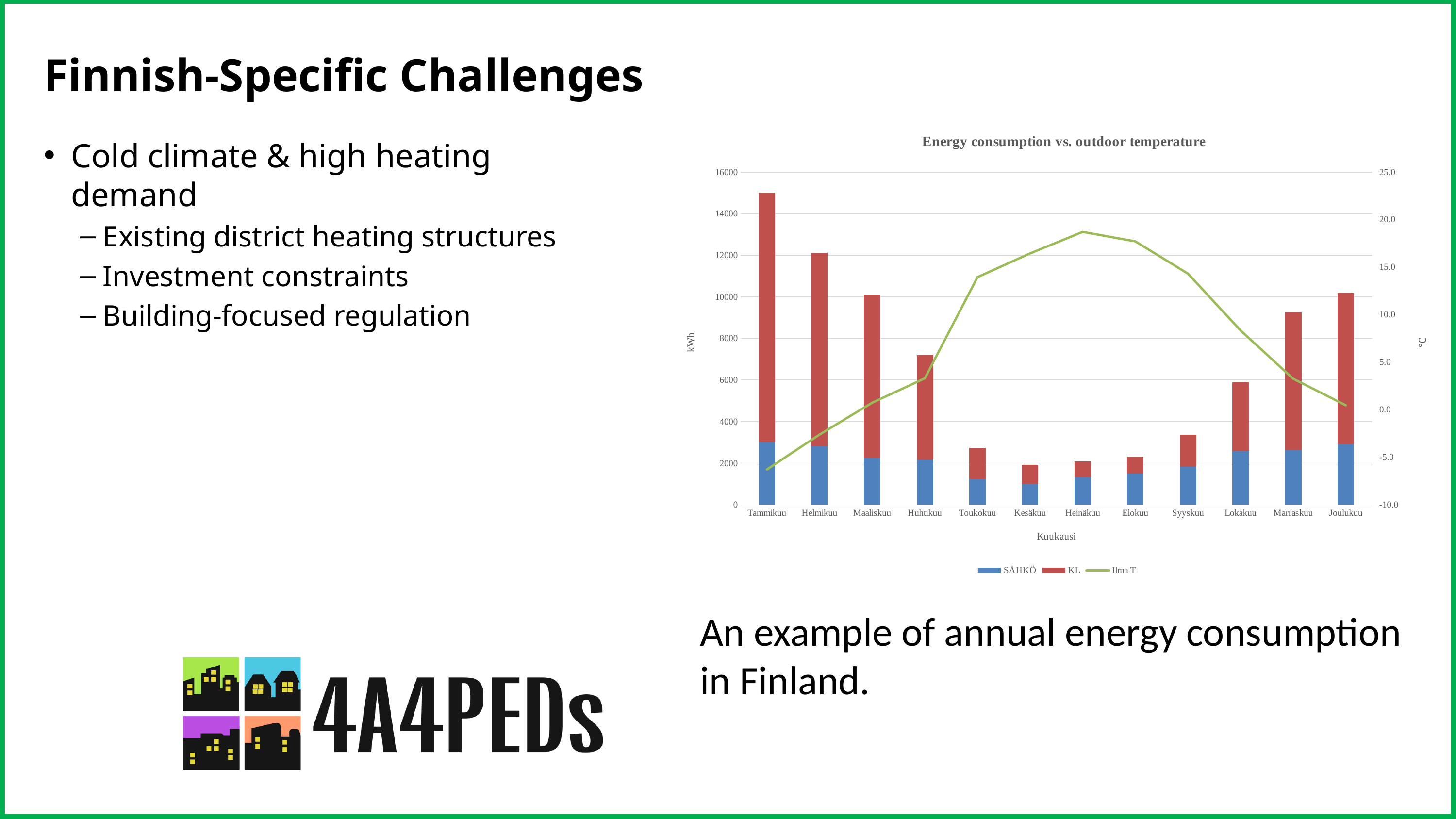
Which month has the larger total energy consumption bar, Tammikuu or Helmikuu? Tammikuu Which series are listed in the chart's legend? SÄHKÖ, KL, Ilma T Is the total energy consumption for Tammikuu greater or less than 14000? greater Is the total energy consumption for Huhtikuu greater or less than 8000? less Is the outdoor temperature (Ilma T) for Heinäkuu greater or less than 15.0? greater What kind of chart is shown on the slide? A stacked bar chart combined with a line chart What is the title of the chart? Energy consumption vs. outdoor temperature Which month has the highest total energy consumption bar? Tammikuu How many months (categories) are shown on the x axis of the chart? 12 Does the outdoor temperature line rise or fall from Tammikuu to Heinäkuu? rise How many series does the chart's legend list? 3